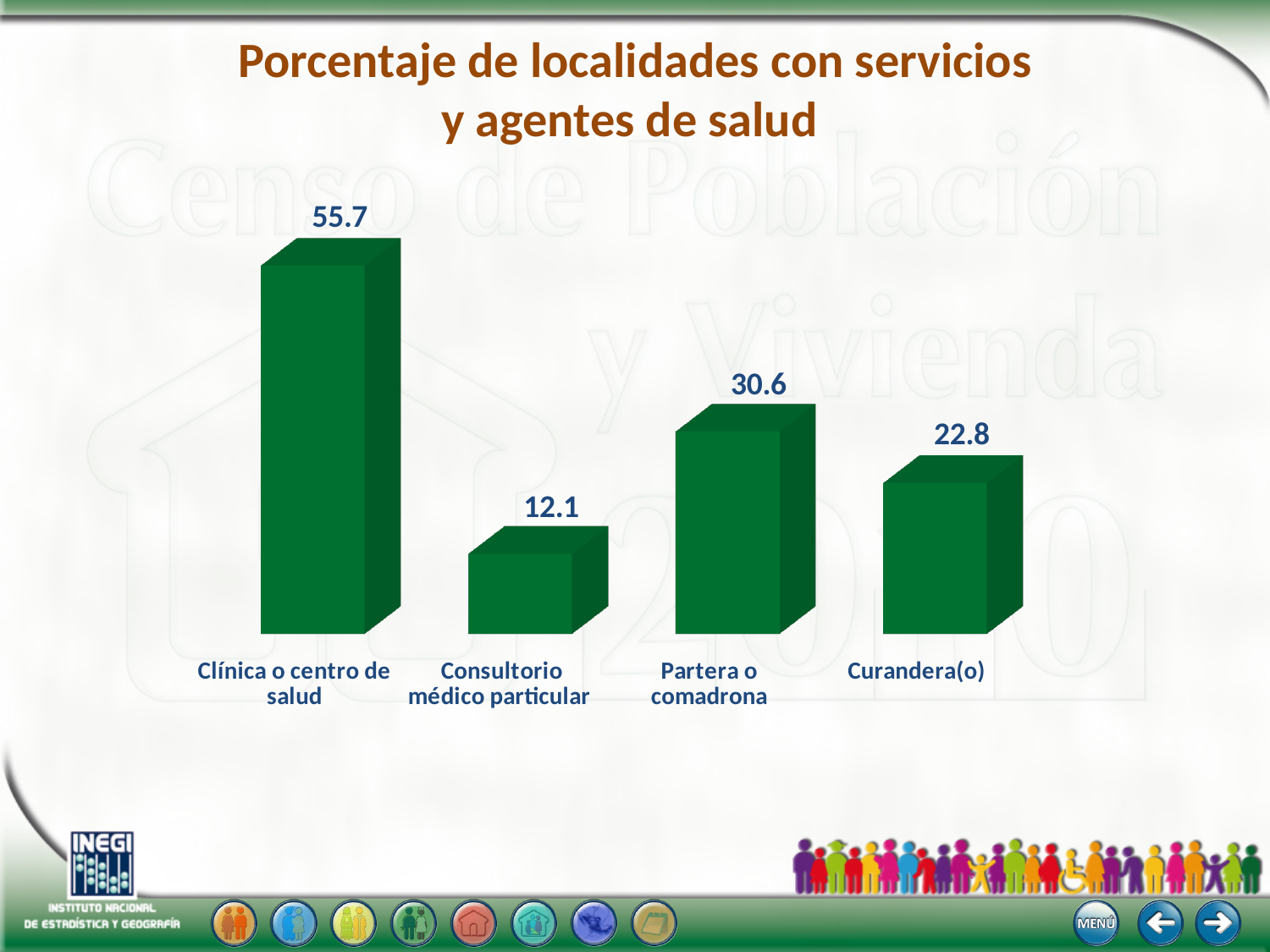
Which is larger, the value for Curandera(o) or the value for Consultorio médico particular? Curandera(o) What is the value for Consultorio médico particular? 12.1 What is the title of the chart? Porcentaje de localidades con servicios y agentes de salud What is the value for Partera o comadrona? 30.6 What kind of chart is shown on the slide? Bar chart What is the value for Clínica o centro de salud? 55.7 What is the difference between the values for Partera o comadrona and Curandera(o)? 7.8 What is the difference between the values for Clínica o centro de salud and Partera o comadrona? 25.1 What is the value for Curandera(o)? 22.8 Which category has the lowest value? Consultorio médico particular Which category has the highest value? Clínica o centro de salud How many categories are shown in the chart? 4